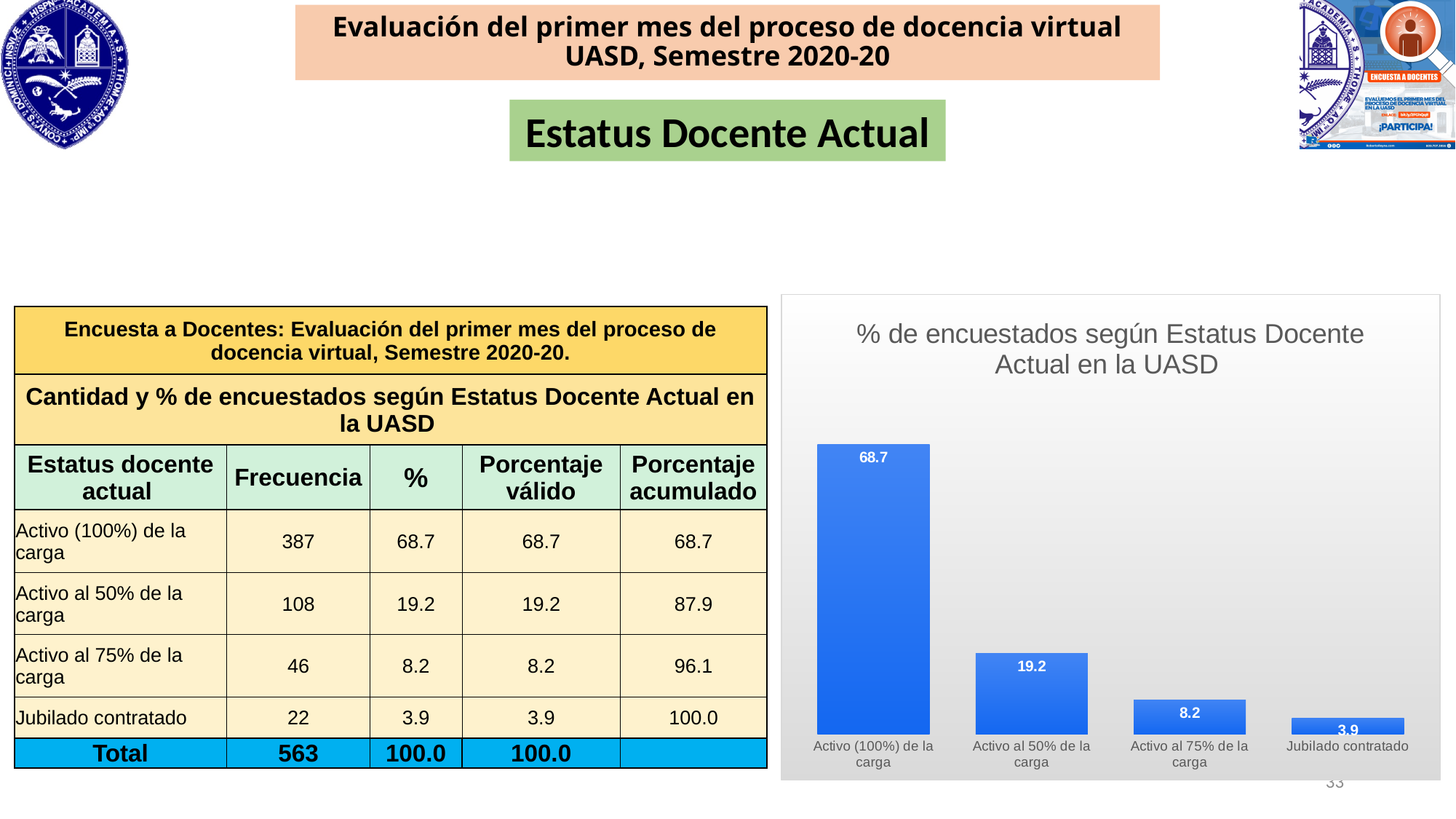
What is the value for 'Jubilado contratado' in the chart? 3.9 What is the title of the chart? % de encuestados según Estatus Docente Actual en la UASD What is the value for 'Activo al 50% de la carga' in the chart? 19.2 What is the difference between the values for 'Activo (100%) de la carga' and 'Activo al 50% de la carga'? 49.5 What is the value for 'Activo (100%) de la carga' in the chart? 68.7 What is the difference between the values for 'Activo al 75% de la carga' and 'Jubilado contratado'? 4.3 Which is larger: the value for 'Activo al 50% de la carga' or 'Activo al 75% de la carga'? Activo al 50% de la carga Which category has the lowest value in the chart? Jubilado contratado What kind of chart is shown on the slide? Bar chart What is the value for 'Activo al 75% de la carga' in the chart? 8.2 Which category has the highest value in the chart? Activo (100%) de la carga How many categories are shown in the chart? 4